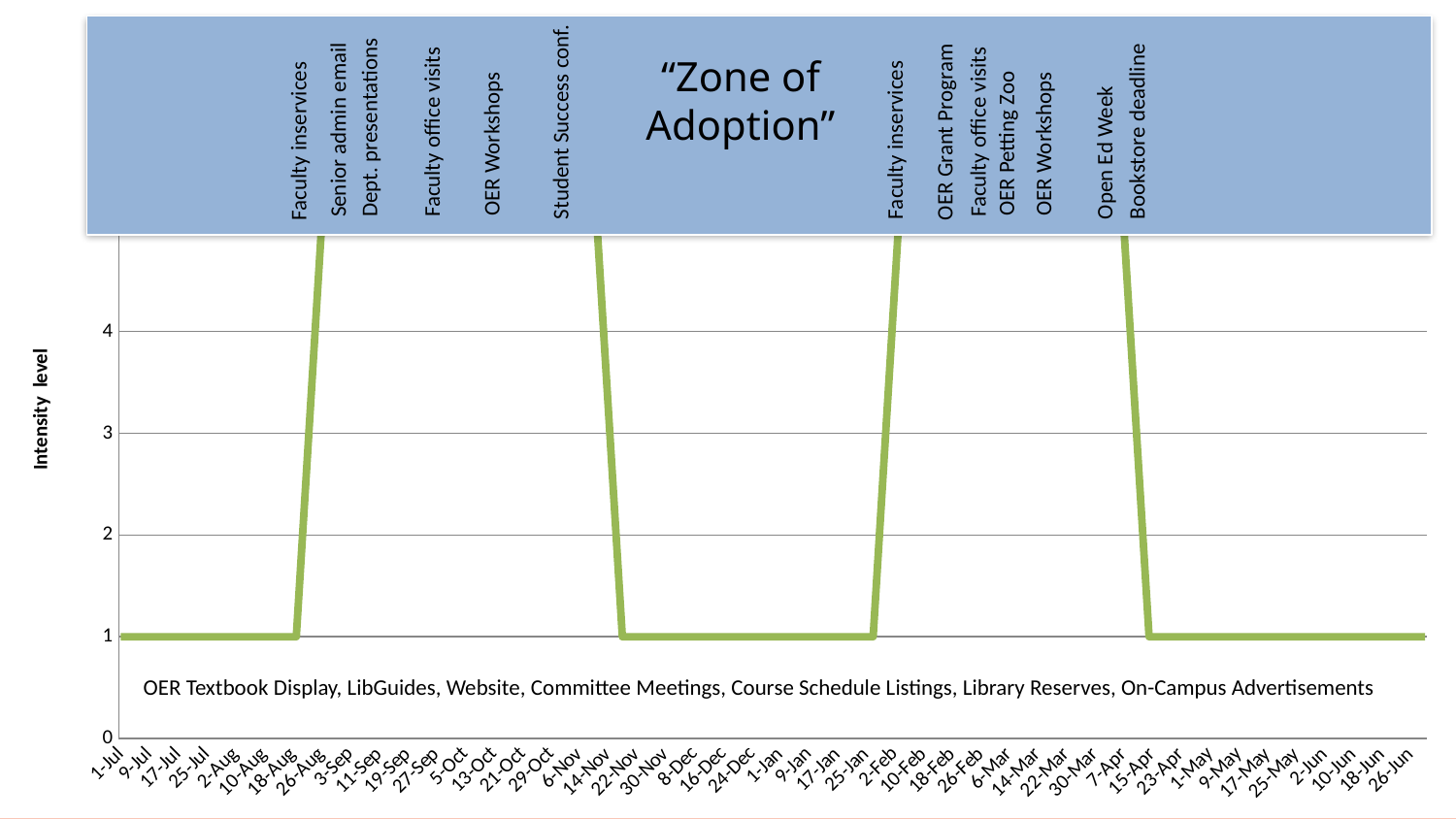
What kind of chart is shown on the slide? line chart What is the intensity level on 1-Jul? 1 Does the intensity level rise or fall between 18-Aug and 3-Sep? rise Is the intensity level on 1-Jan greater or less than 2? less What is the title of the vertical axis? Intensity level Is the intensity level on 27-Sep greater or less than 4? greater Does the intensity level rise or fall between 14-Nov and 22-Nov? fall What is the intensity level on 8-Dec? 1 Which date has the higher intensity level, 3-Sep or 8-Dec? 3-Sep What is the intensity level on 26-Jun? 1 What phrase is printed in large text in the blue band above the chart? "Zone of Adoption" Is the intensity level on 22-Mar greater or less than 3? greater